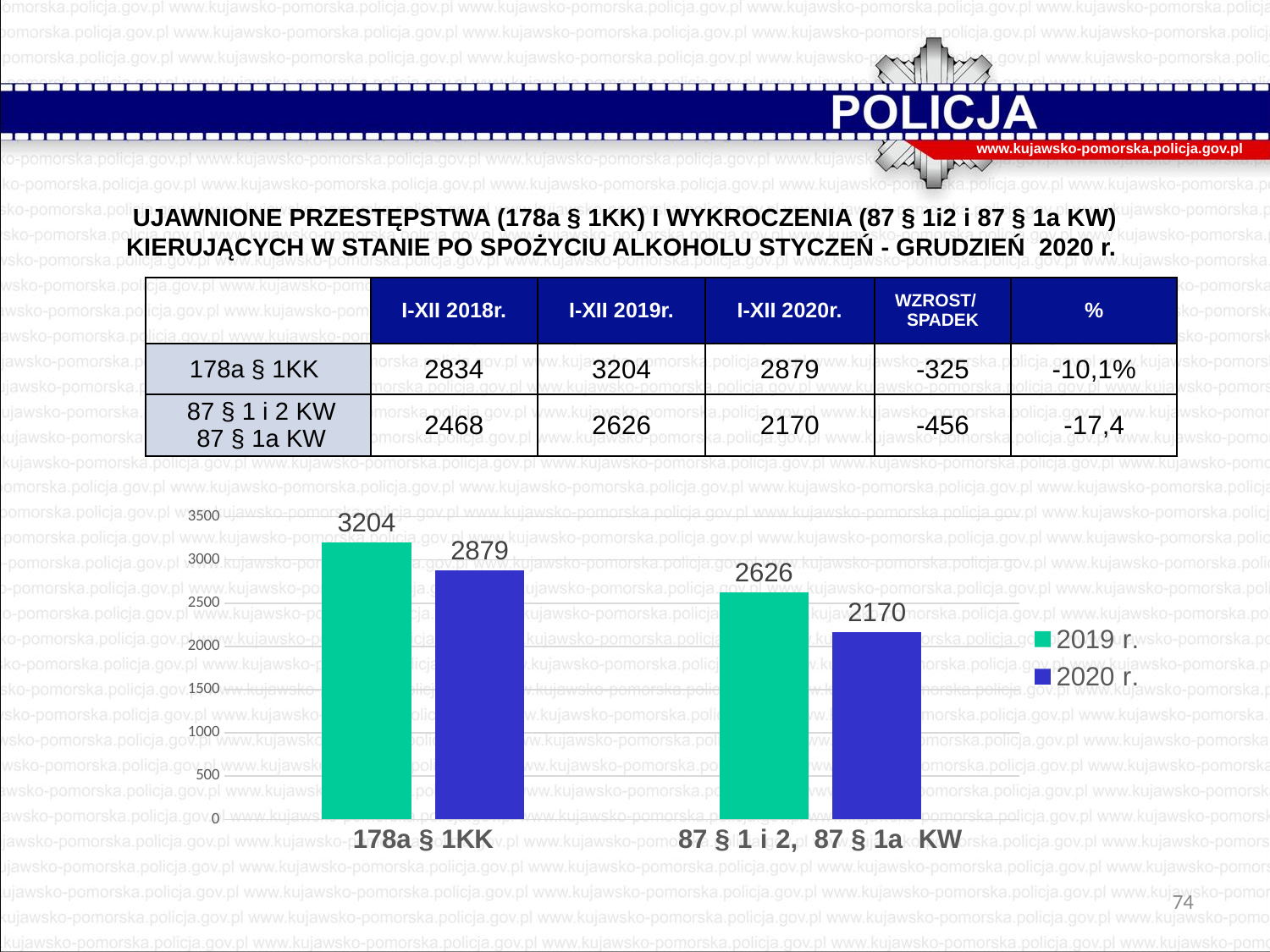
What is the value for 2020 r. in the category 87 § 1 i 2, 87 § 1a KW? 2170 How many series does the chart legend list? 2 What is the value for 2019 r. in the category 178a § 1KK? 3204 Which bar in the chart has the highest value? 2019 r. for 178a § 1KK Which bar in the chart has the lowest value? 2020 r. for 87 § 1 i 2, 87 § 1a KW What is the value for 2020 r. in the category 178a § 1KK? 2879 What type of chart is shown on the slide? bar chart What is the value for 2019 r. in the category 87 § 1 i 2, 87 § 1a KW? 2626 Which series is shown in green in the chart? 2019 r. What is the difference between the 2019 r. and 2020 r. values for 87 § 1 i 2, 87 § 1a KW? 456 What is the difference between the 2019 r. and 2020 r. values for 178a § 1KK? 325 How many categories are shown on the x axis of the chart? 2